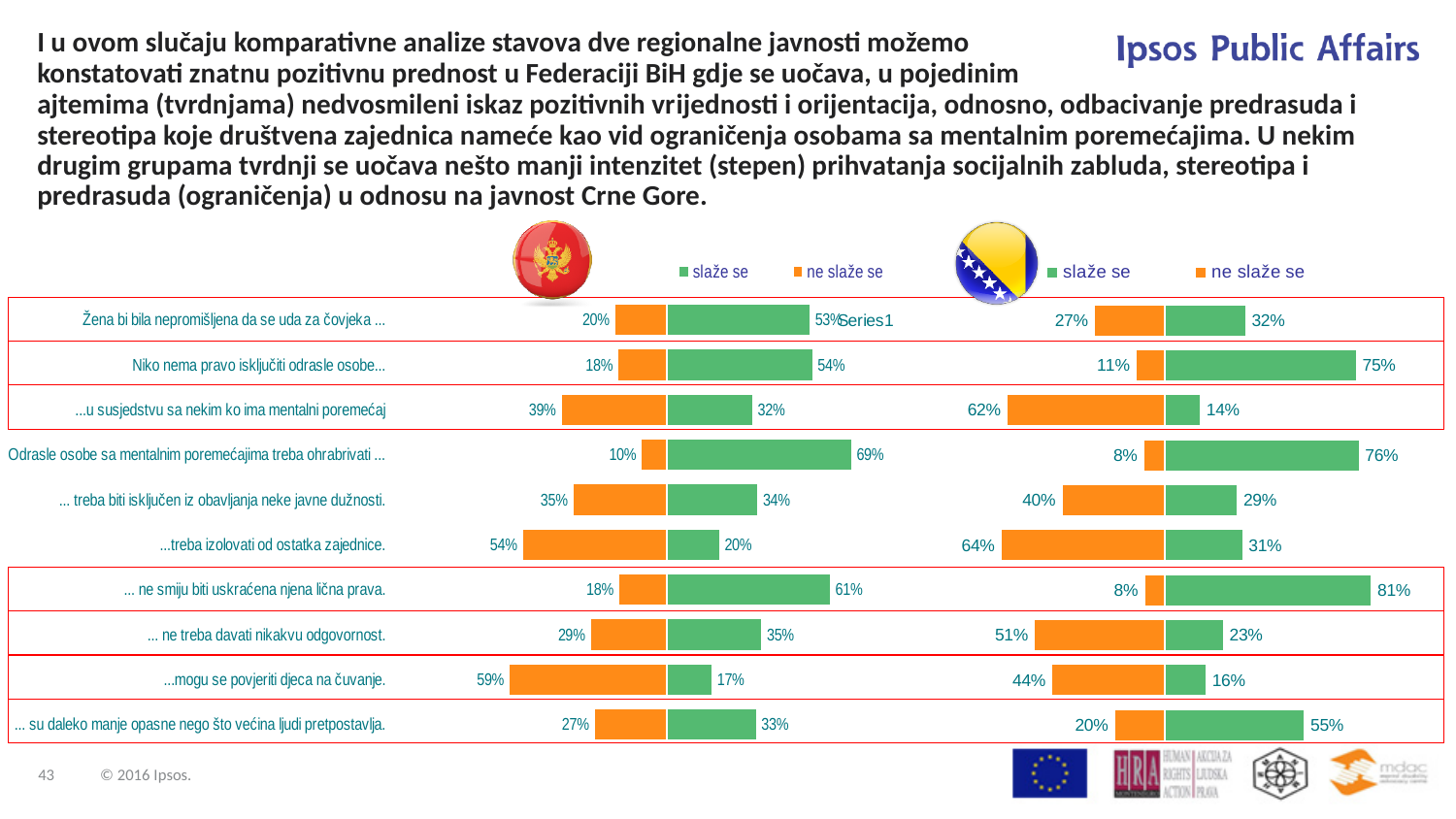
In the left chart, what is the difference between the 'ne slaže se' and 'slaže se' values for '...mogu se povjeriti djeca na čuvanje.'? 42% In the right chart, which is larger for '...treba izolovati od ostatka zajednice.': 'slaže se' or 'ne slaže se'? ne slaže se In the right chart, what is the 'ne slaže se' value for '...u susjedstvu sa nekim ko ima mentalni poremećaj'? 62% In the right chart, what is the 'slaže se' value for 'Niko nema pravo isključiti odrasle osobe...'? 75% How many series does the legend of the right chart list? 2 In the left chart, what is the 'slaže se' value for 'Odrasle osobe sa mentalnim poremećajima treba ohrabrivati ...'? 69% In the left chart, what is the 'ne slaže se' value for '... treba biti isključen iz obavljanja neke javne dužnosti.'? 35% How many categories (statements) are shown in the left chart? 10 In the left chart, which category has the lowest 'ne slaže se' value? Odrasle osobe sa mentalnim poremećajima treba ohrabrivati ... In the right chart, which category has the highest 'slaže se' value? ... ne smiju biti uskraćena njena lična prava. In the right chart, which colour represents the 'slaže se' series? green What type of chart is the left chart? bar chart